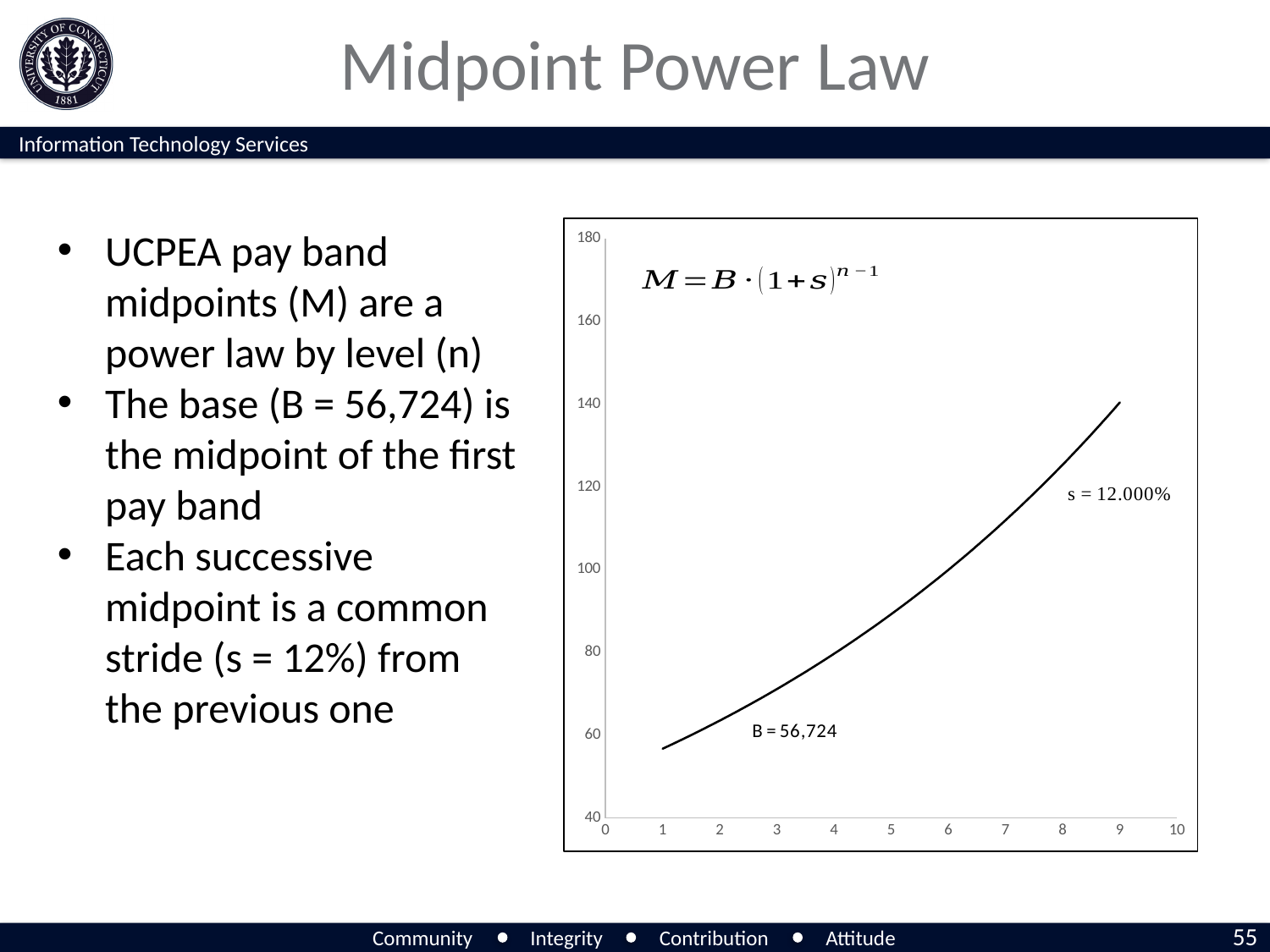
Do the plotted values rise or fall as the level (x axis) increases? rise Is the value of the curve at x = 3 greater or less than 80? less What value of s is annotated on the chart? s = 12.000% Is the value of the curve at x = 1 greater or less than 80? less At which x-axis value does the curve have its lowest point? 1 Is the value of the curve at x = 5 greater or less than 100? less What kind of chart is shown on the slide? line chart At which x-axis value does the curve reach its highest point? 9 Which is larger, the value of the curve at x = 2 or at x = 8? x = 8 What value of B is annotated on the chart? B = 56,724